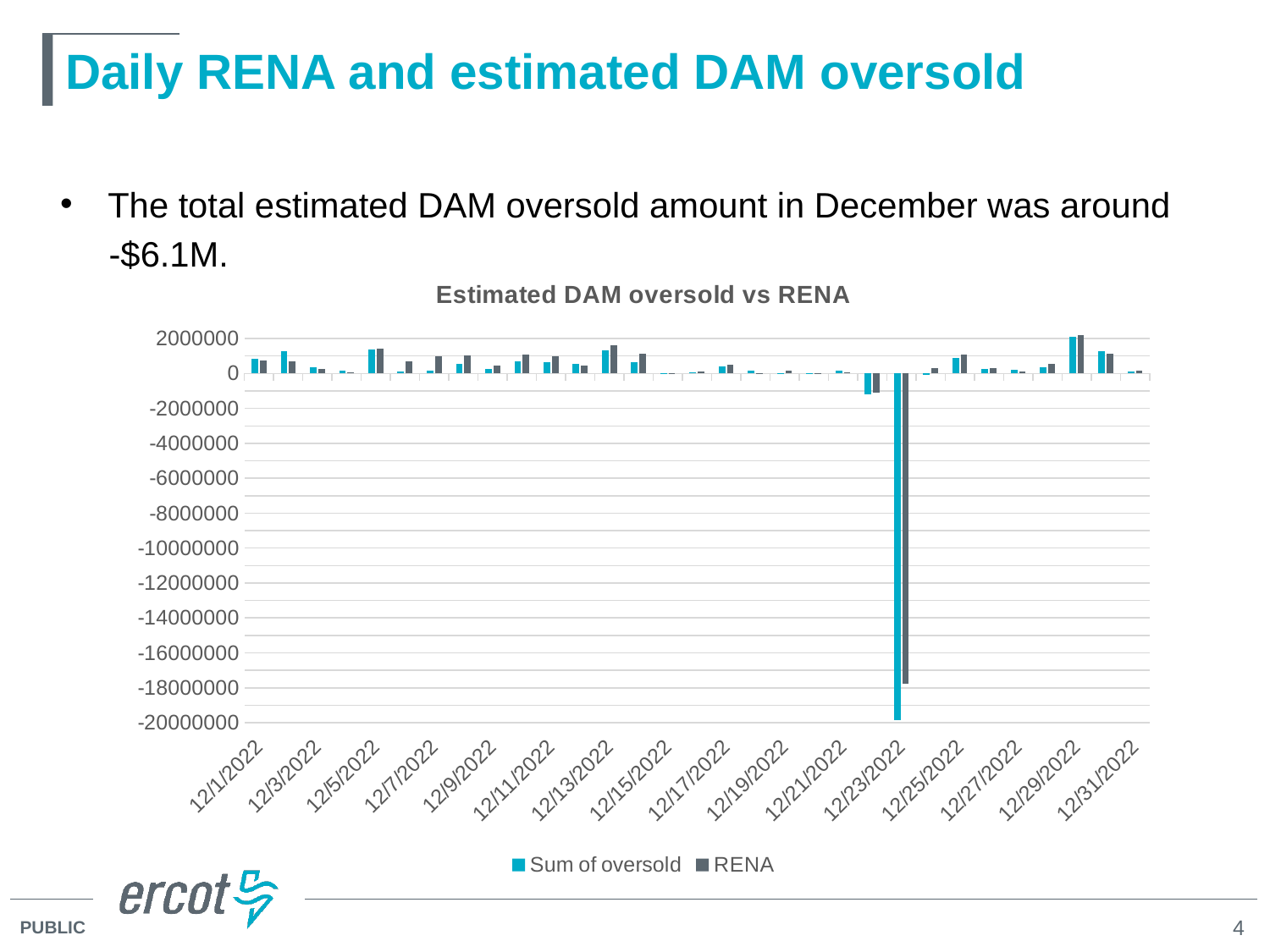
On which date is the RENA value highest? 12/29/2022 On which date is the RENA value lowest? 12/23/2022 How many series does the chart legend list? 2 What are the two series named in the chart legend? Sum of oversold and RENA What is the title of the chart? Estimated DAM oversold vs RENA Is the RENA value for 12/23/2022 greater or less than -16000000? less On 12/23/2022, which series has the larger value, Sum of oversold or RENA? RENA Is the Sum of oversold value for 12/23/2022 greater or less than -18000000? less On which date is the Sum of oversold value highest? 12/29/2022 How many date labels are shown along the x axis? 16 On which date is the Sum of oversold value lowest? 12/23/2022 What kind of chart is shown on the slide? bar chart